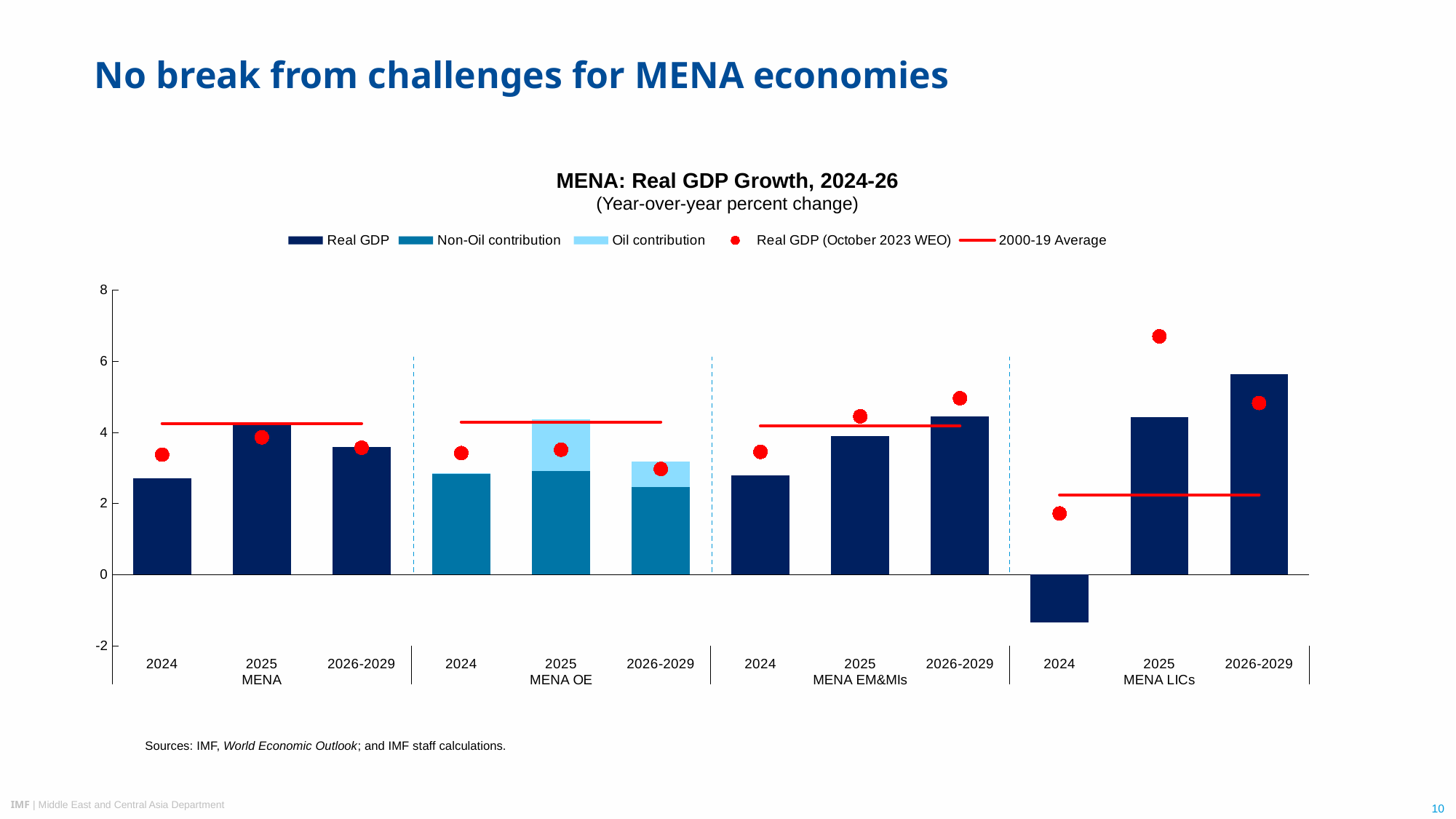
Which legend entry is shown as a red horizontal line? 2000-19 Average Is the Real GDP value for MENA LICs in 2026-2029 greater or less than 4? greater Which bar has the lowest value in the chart? MENA LICs, 2024 For MENA LICs in 2025, is the Real GDP (October 2023 WEO) dot above or below the top of the bar? above What kind of chart is shown on the slide? Bar chart How many country groups are shown along the x axis? 4 Is the Real GDP value for MENA LICs in 2024 greater or less than 0? less How many series does the legend list? 5 Do the Real GDP bars for MENA EM&MIs rise or fall from 2024 to 2026-2029? rise Which is larger for MENA: the Real GDP bar for 2024 or for 2025? 2025 Which bar has the highest value in the chart? MENA LICs, 2026-2029 Is the Real GDP value for MENA in 2024 greater or less than 4? less